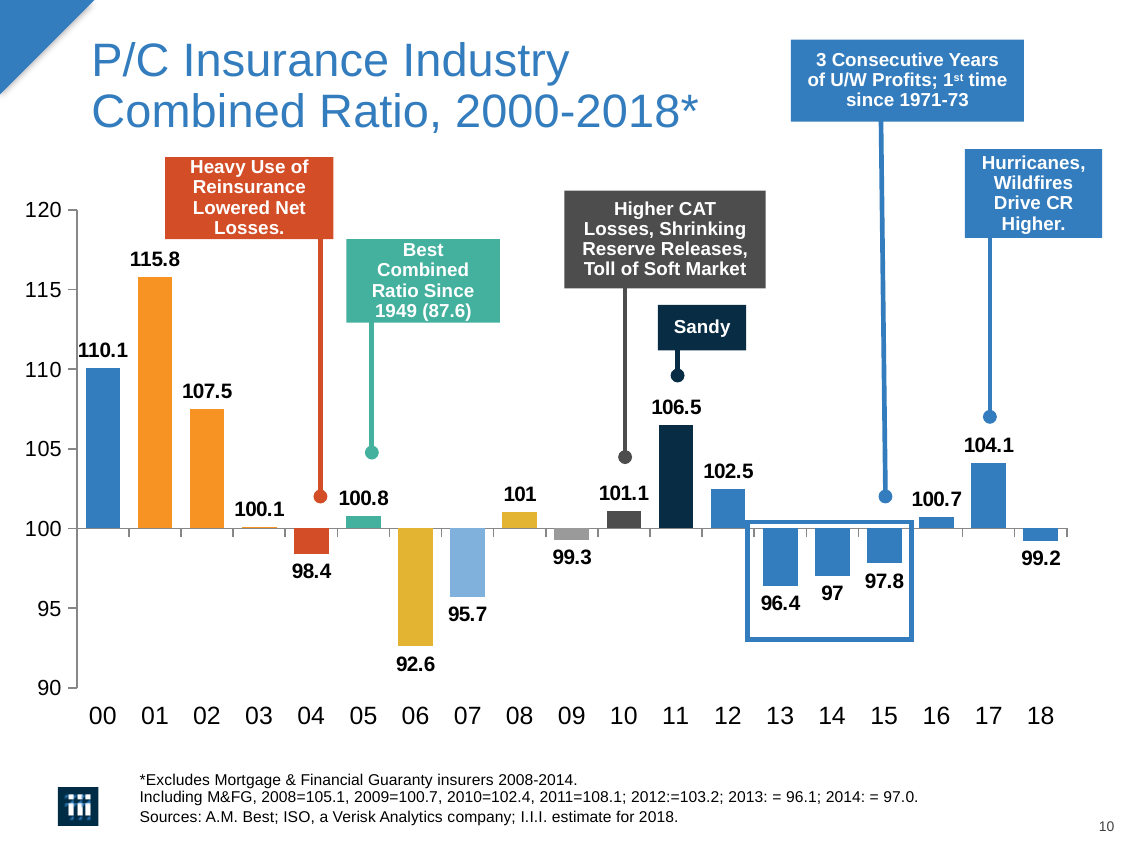
What is the combined ratio for 2018? 99.2 Which year has the highest combined ratio? 01 Which year has a higher combined ratio, 2012 or 2017? 2017 What kind of chart is shown on the slide? bar chart What is the combined ratio for 2006? 92.6 What is the difference between the combined ratio in 2001 and in 2006? 23.2 What is the combined ratio for 2011? 106.5 Which year has the lowest combined ratio? 06 How many years are shown on the x axis? 19 What is the combined ratio for 2001? 115.8 What is the title of the chart? P/C Insurance Industry Combined Ratio, 2000-2018* Is the value for 2013 greater or less than 100? less